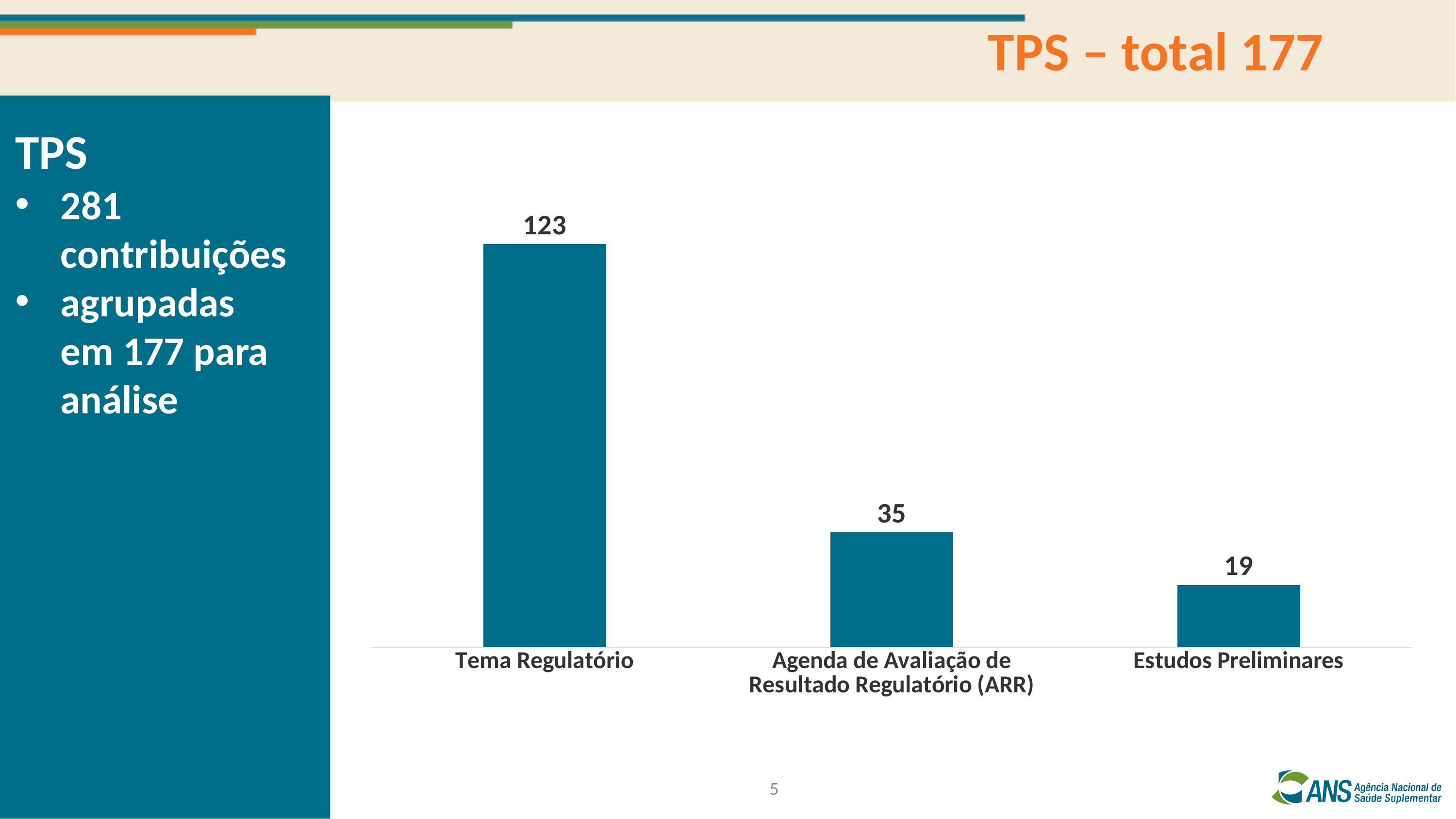
What kind of chart is shown on the slide? Bar chart Do the values rise or fall from left to right across the categories? Fall What is the difference between the values for Agenda de Avaliação de Resultado Regulatório (ARR) and Estudos Preliminares? 16 Which category has the lowest value? Estudos Preliminares Which is larger, the value for Agenda de Avaliação de Resultado Regulatório (ARR) or the value for Estudos Preliminares? Agenda de Avaliação de Resultado Regulatório (ARR) Which category has the highest value? Tema Regulatório What is the value for Tema Regulatório? 123 What is the difference between the values for Tema Regulatório and Agenda de Avaliação de Resultado Regulatório (ARR)? 88 What is the value for Estudos Preliminares? 19 How many categories are shown in the chart? 3 What is the total of the three values shown in the chart? 177 What is the value for Agenda de Avaliação de Resultado Regulatório (ARR)? 35